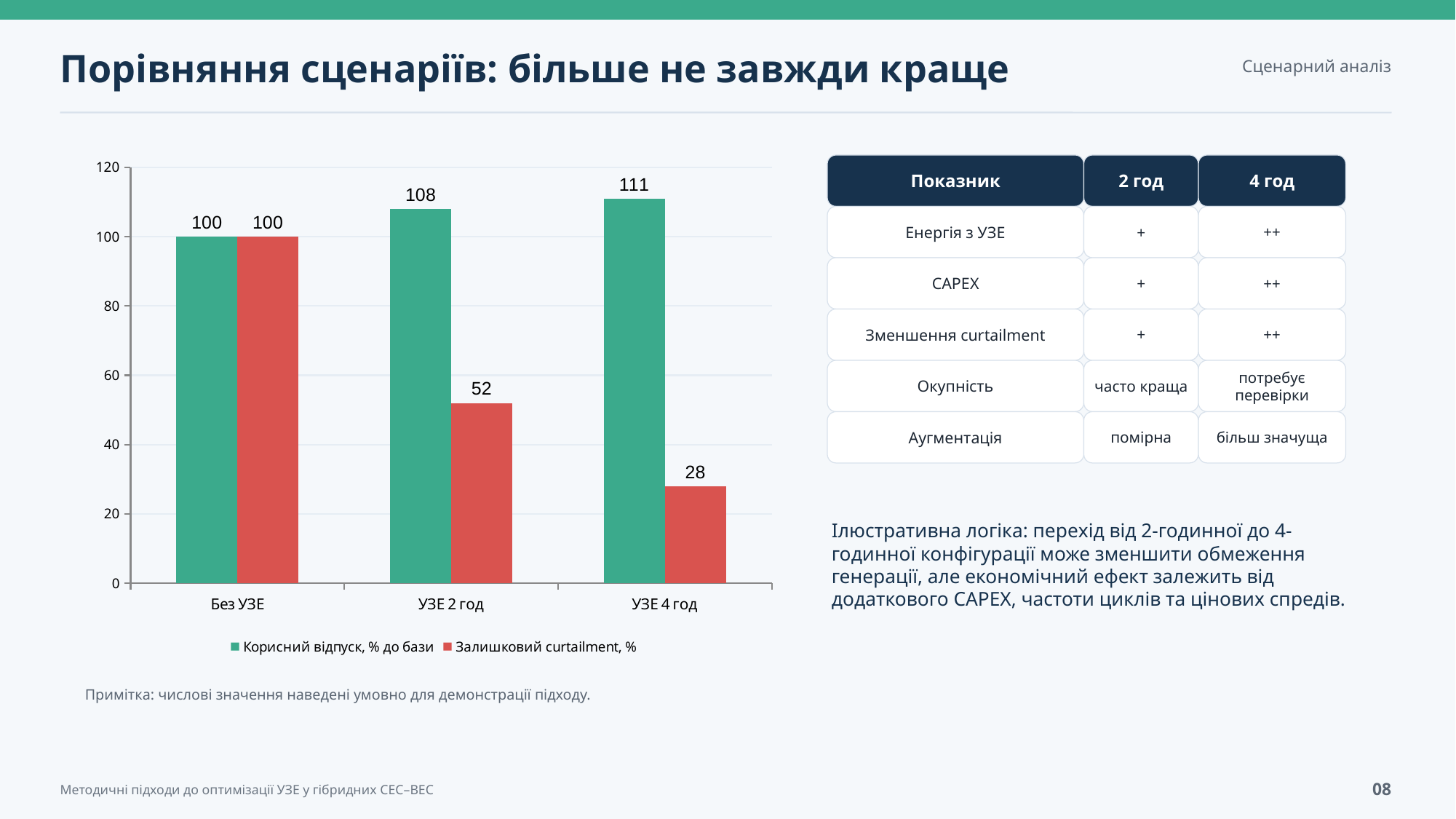
What is the difference between 'Залишковий curtailment, %' for 'УЗЕ 2 год' and 'УЗЕ 4 год'? 24 Is the value of 'Залишковий curtailment, %' for 'УЗЕ 2 год' greater or less than 60? less What is the value of 'Корисний відпуск, % до бази' for 'УЗЕ 2 год'? 108 What is the value of 'Залишковий curtailment, %' for 'Без УЗЕ'? 100 Which is larger: 'Корисний відпуск, % до бази' for 'УЗЕ 2 год' or for 'УЗЕ 4 год'? УЗЕ 4 год Which category has the highest value for 'Корисний відпуск, % до бази'? УЗЕ 4 год Do the values of 'Залишковий curtailment, %' rise or fall from 'Без УЗЕ' to 'УЗЕ 4 год'? fall What is the value of 'Залишковий curtailment, %' for 'УЗЕ 4 год'? 28 Which category has the lowest value for 'Залишковий curtailment, %'? УЗЕ 4 год How many series does the legend list? 2 What kind of chart is shown on the slide? bar chart How many categories are shown on the x axis? 3